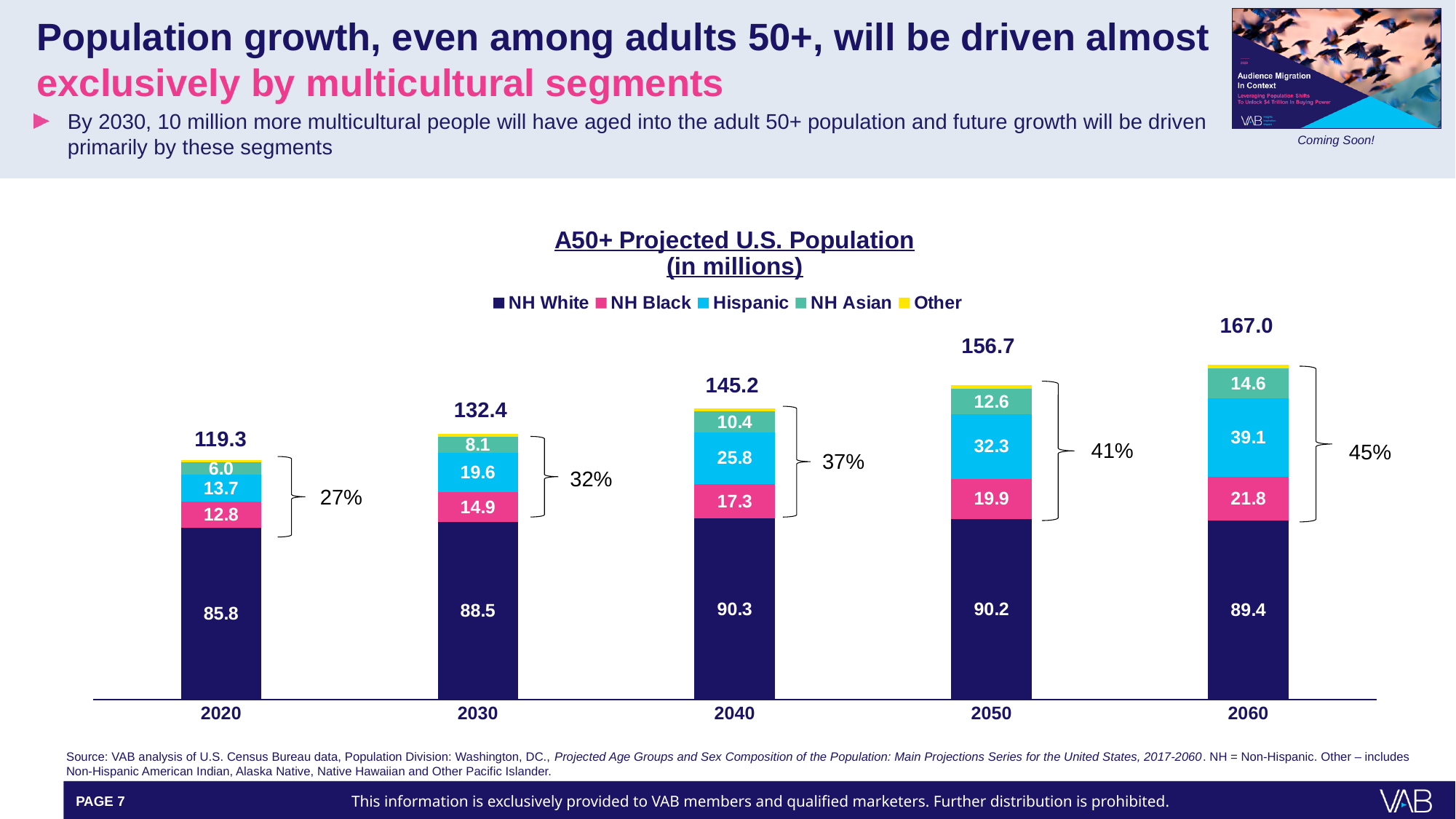
What is the Hispanic value for 2040? 25.8 What kind of chart is shown on the slide? Stacked bar chart How many years are shown along the x axis? 5 In which year is the Hispanic value highest? 2060 In which year is the total A50+ population lowest? 2020 What is the difference between the Hispanic value in 2060 and in 2020? 25.4 Which is larger in 2030, the NH Black value or the Hispanic value? Hispanic What is the NH Black value for 2020? 12.8 How many series does the legend list? 5 What is the total A50+ projected population for 2050? 156.7 What is the NH Asian value for 2060? 14.6 Do the total A50+ population values rise or fall from 2020 to 2060? Rise